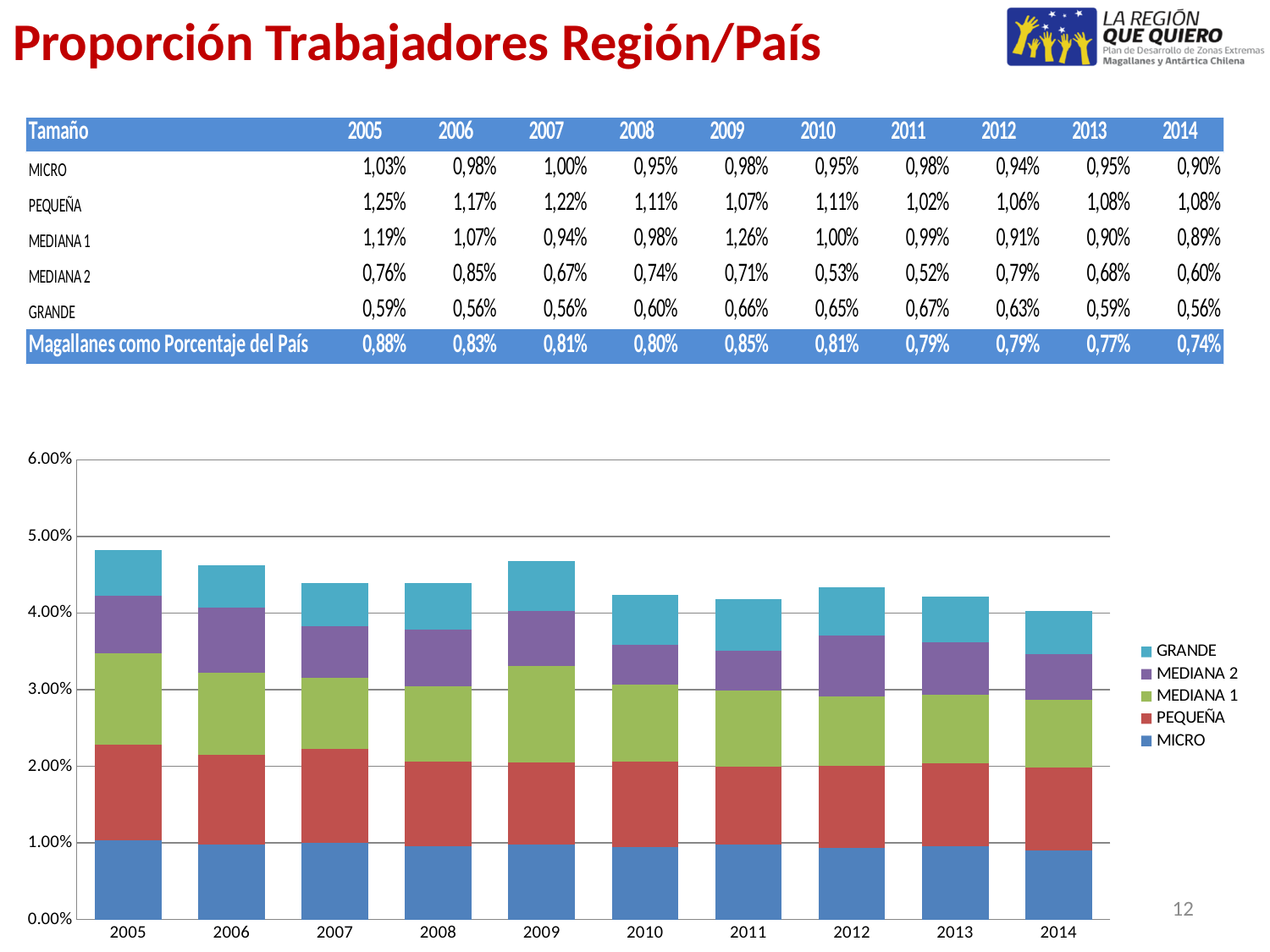
How many years are shown along the x axis of the chart? 10 Which year has the tallest stacked bar in the chart? 2005 Do the total heights of the stacked bars generally rise or fall from 2005 to 2014? fall What is the value of the GRANDE series for 2011? 0,67% Is the total height of the stacked bar for 2005 greater or less than 4.00%? greater What is the total of the stacked bar for 2005 (sum of MICRO, PEQUEÑA, MEDIANA 1, MEDIANA 2 and GRANDE)? 4,82% What is the value of the MICRO series for 2014? 0,90% How many series does the chart's legend list? 5 Which year has the shortest stacked bar in the chart? 2014 Which series is listed first (at the top) in the chart's legend? GRANDE Is the total height of the stacked bar for 2014 greater or less than 5.00%? less What kind of chart is shown on the slide? bar chart